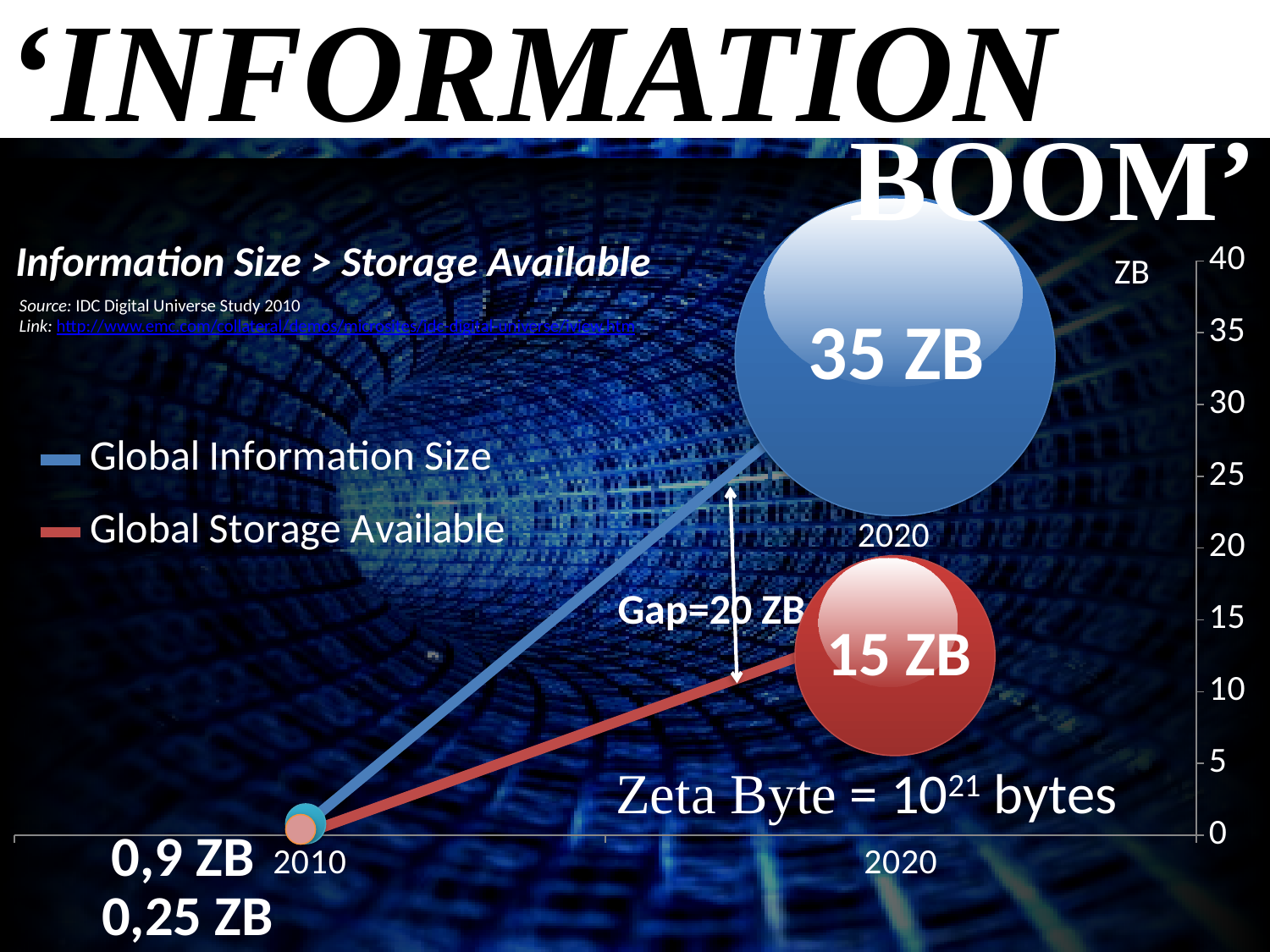
What is the Global Storage Available in 2020? 15 ZB What kind of chart is shown on the slide? line chart Which is larger in 2020, Global Information Size or Global Storage Available? Global Information Size Is the Global Information Size in 2020 greater or less than 30? greater What is the Global Information Size in 2010? 0,9 ZB How many series does the legend list? 2 What unit is shown on the vertical axis of the chart? ZB What is the Global Storage Available in 2010? 0,25 ZB Is the Global Storage Available in 2020 greater or less than 20? less What is the Global Information Size in 2020? 35 ZB What is the difference between Global Information Size and Global Storage Available in 2020? 20 ZB Does the Global Information Size rise or fall from 2010 to 2020? rise